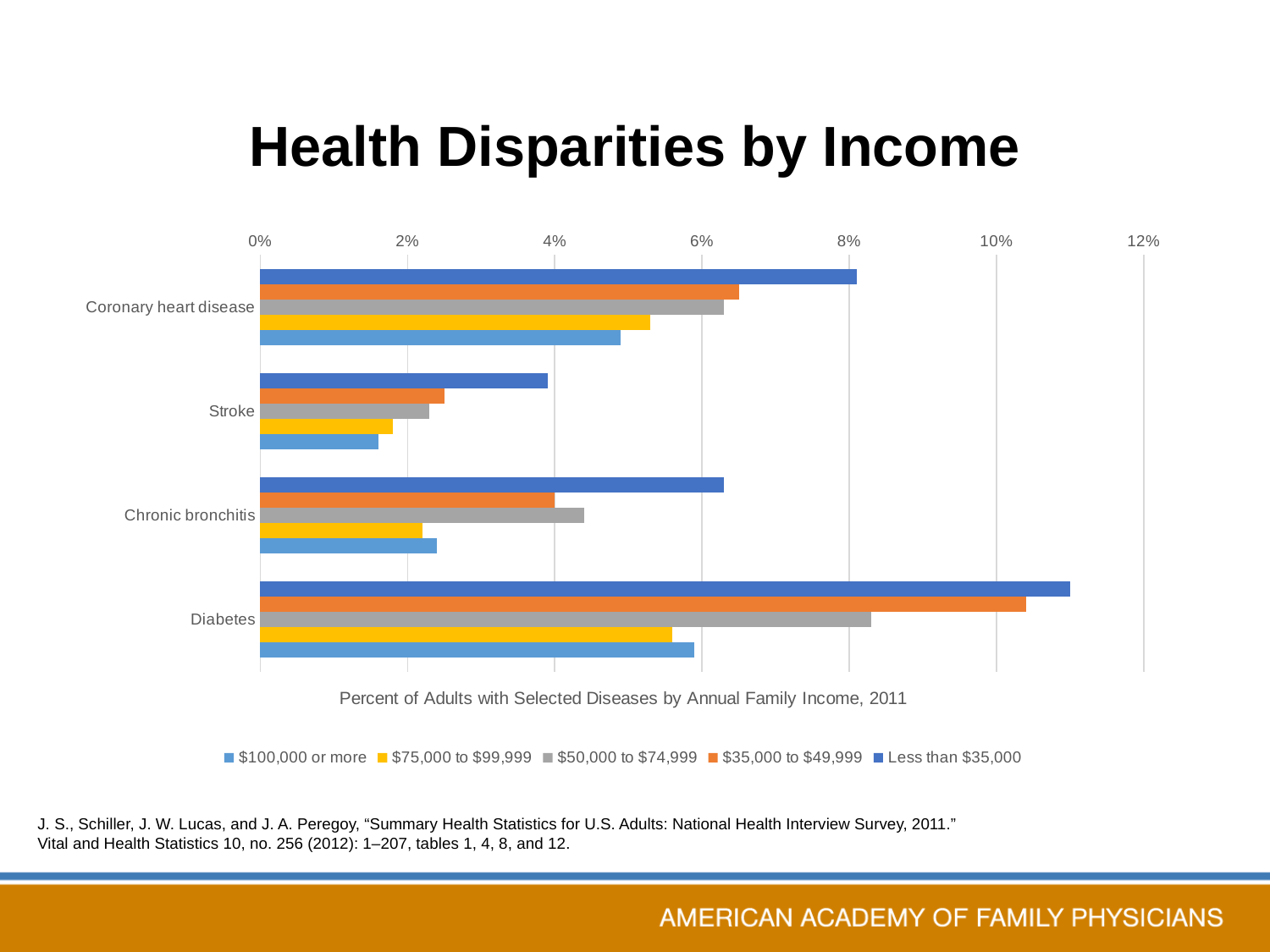
How many income groups does the legend list? 5 What is the caption printed below the chart's horizontal axis? Percent of Adults with Selected Diseases by Annual Family Income, 2011 For Chronic bronchitis, which is larger: the value for $50,000 to $74,999 or the value for $35,000 to $49,999? $50,000 to $74,999 How many disease categories are plotted on the chart? 4 Is the value for Coronary heart disease in the $100,000 or more group greater or less than 6%? less What kind of chart is shown on the slide? bar chart Is the value for Stroke in the Less than $35,000 group greater or less than 2%? greater For Diabetes, which is larger: the value for Less than $35,000 or the value for $100,000 or more? Less than $35,000 Which income group has the highest percentage for Diabetes? Less than $35,000 For the Less than $35,000 income group, which disease has the highest percentage? Diabetes Is the value for Diabetes in the Less than $35,000 group greater or less than 10%? greater For the Less than $35,000 income group, which disease has the lowest percentage? Stroke